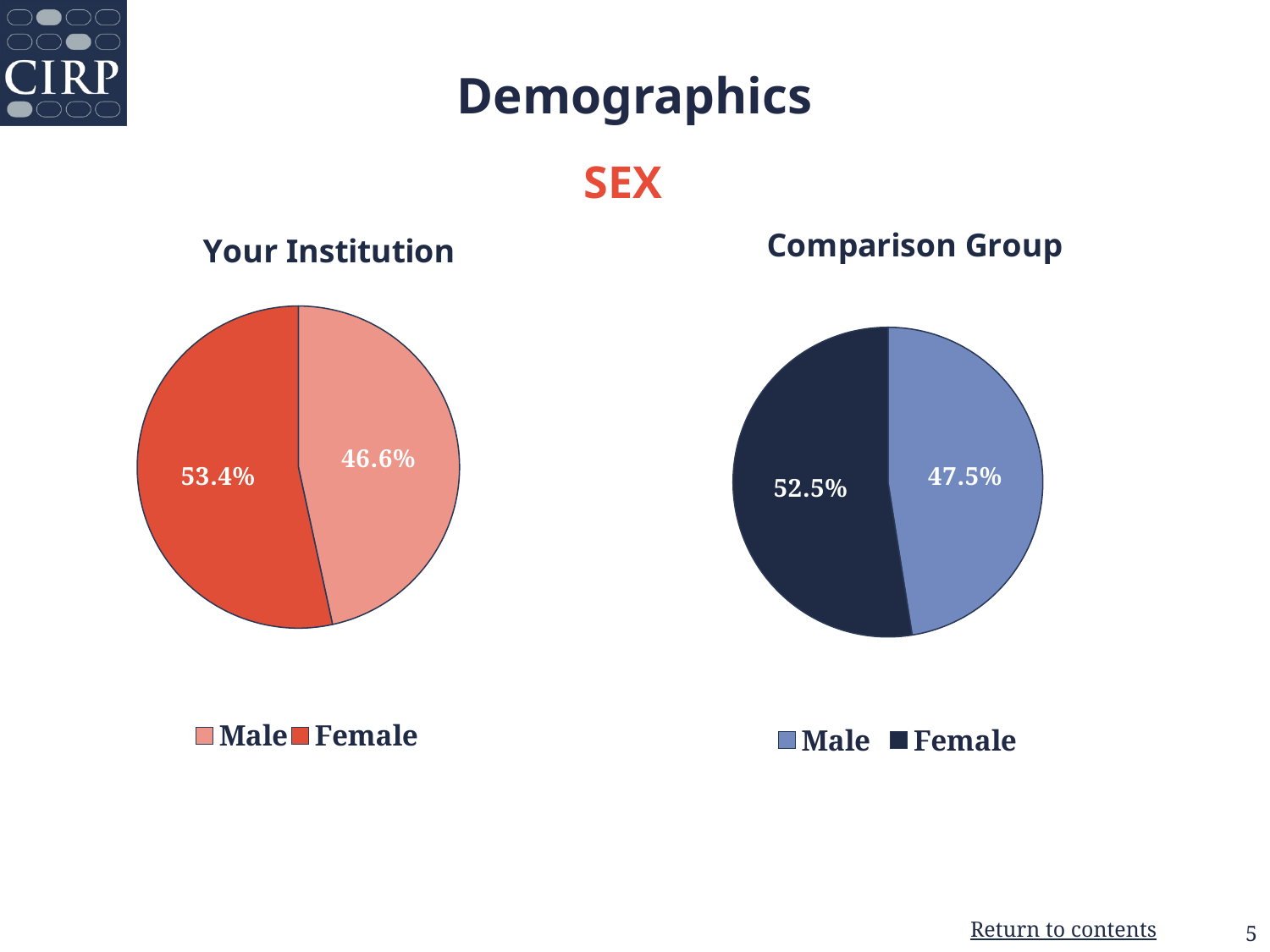
What type of chart is the Your Institution chart? Pie chart In the Your Institution chart, which category has the largest share? Female How many categories does the Comparison Group chart show? 2 In the Comparison Group chart, what colour is the Female slice? Dark navy blue In the Comparison Group chart, what percentage is Male? 47.5% Which is larger: the Male share in the Your Institution chart or the Male share in the Comparison Group chart? Comparison Group In the Your Institution chart, what percentage is Male? 46.6% In the Comparison Group chart, what is the difference between the Female and Male shares? 5.0% In the Comparison Group chart, what percentage is Female? 52.5% In the Your Institution chart, what is the difference between the Female and Male shares? 6.8% In the Your Institution chart, what percentage is Female? 53.4% In the Comparison Group chart, which category has the smallest share? Male